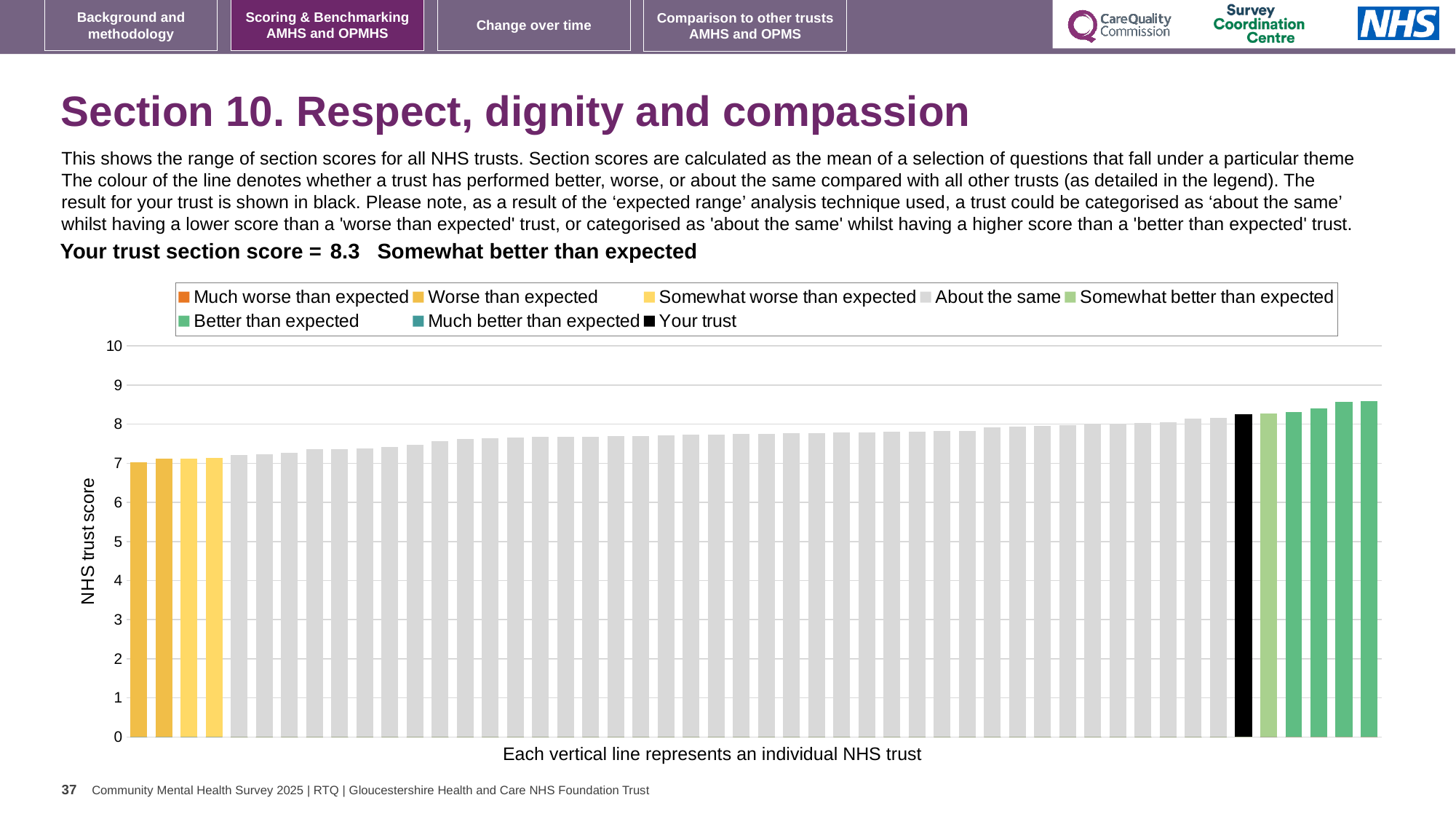
Do the bar values rise or fall from left to right along the x axis? rise What colour is the bar representing your trust? black Is the value of the highest bar greater or less than 9? less How many entries does the chart legend list? 8 Which category is your trust placed in for this section? Somewhat better than expected What is the label on the y axis of the chart? NHS trust score What kind of chart is shown on the slide? bar chart How many bars are shown to the right of the black 'Your trust' bar? 5 How many yellow bars are shown at the left end of the chart? 4 Is the value of the lowest bar (leftmost) greater or less than 8? less What is the section score for your trust? 8.3 Is the value for your trust (the black bar) greater or less than 8? greater